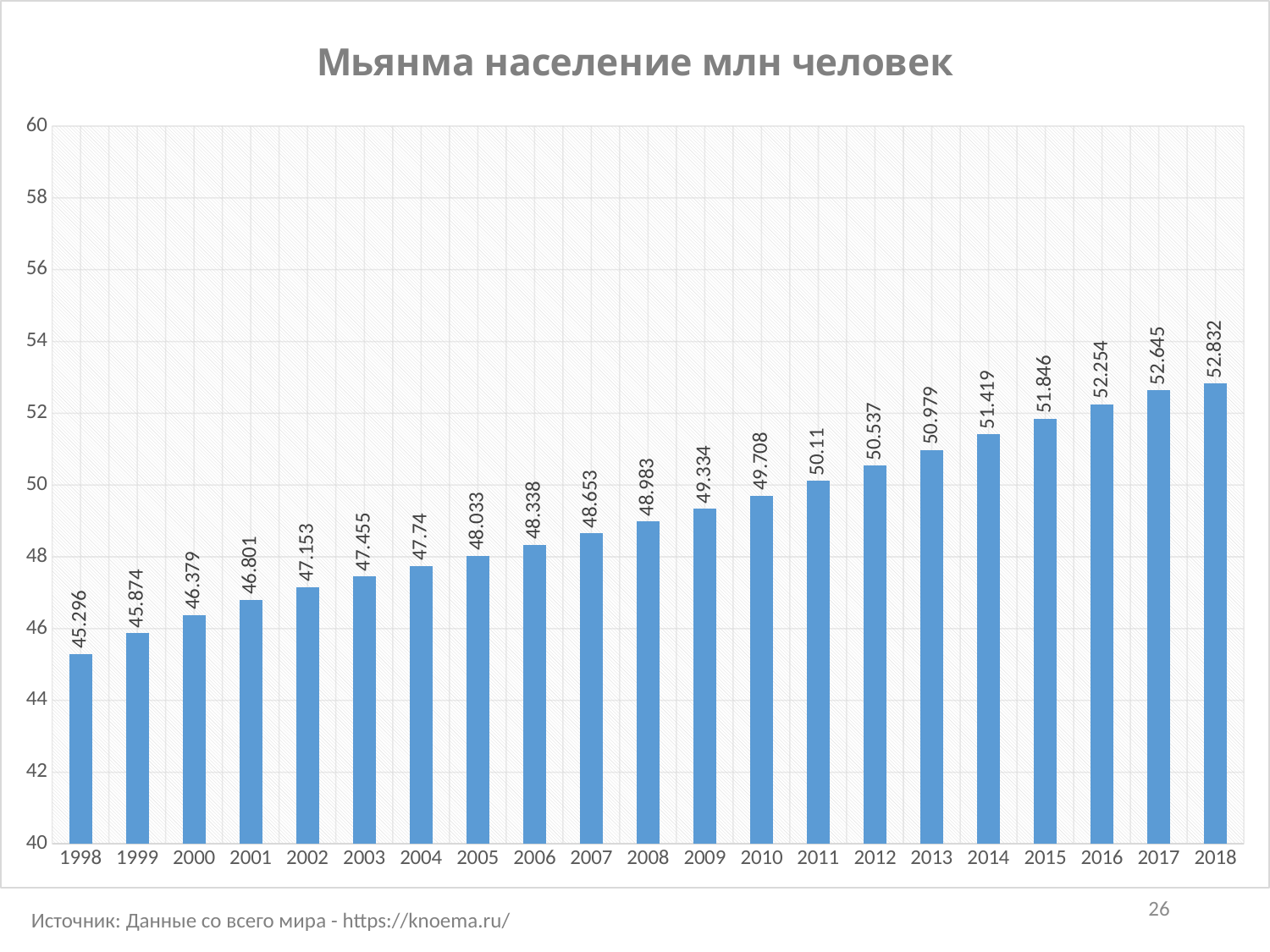
Which year has the lowest value? 1998 What is the value for 2018? 52.832 How many years are shown on the x axis? 21 What is the difference between the values for 2018 and 1998? 7.536 What is the value for 2011? 50.11 What is the value for 2004? 47.74 What kind of chart is this? bar chart Is the value for 2013 greater or less than 50? greater What is the value for 1998? 45.296 Which is larger, the value for 2005 or the value for 2009? 2009 Do the values rise or fall from 1998 to 2018? rise Which year has the highest value? 2018